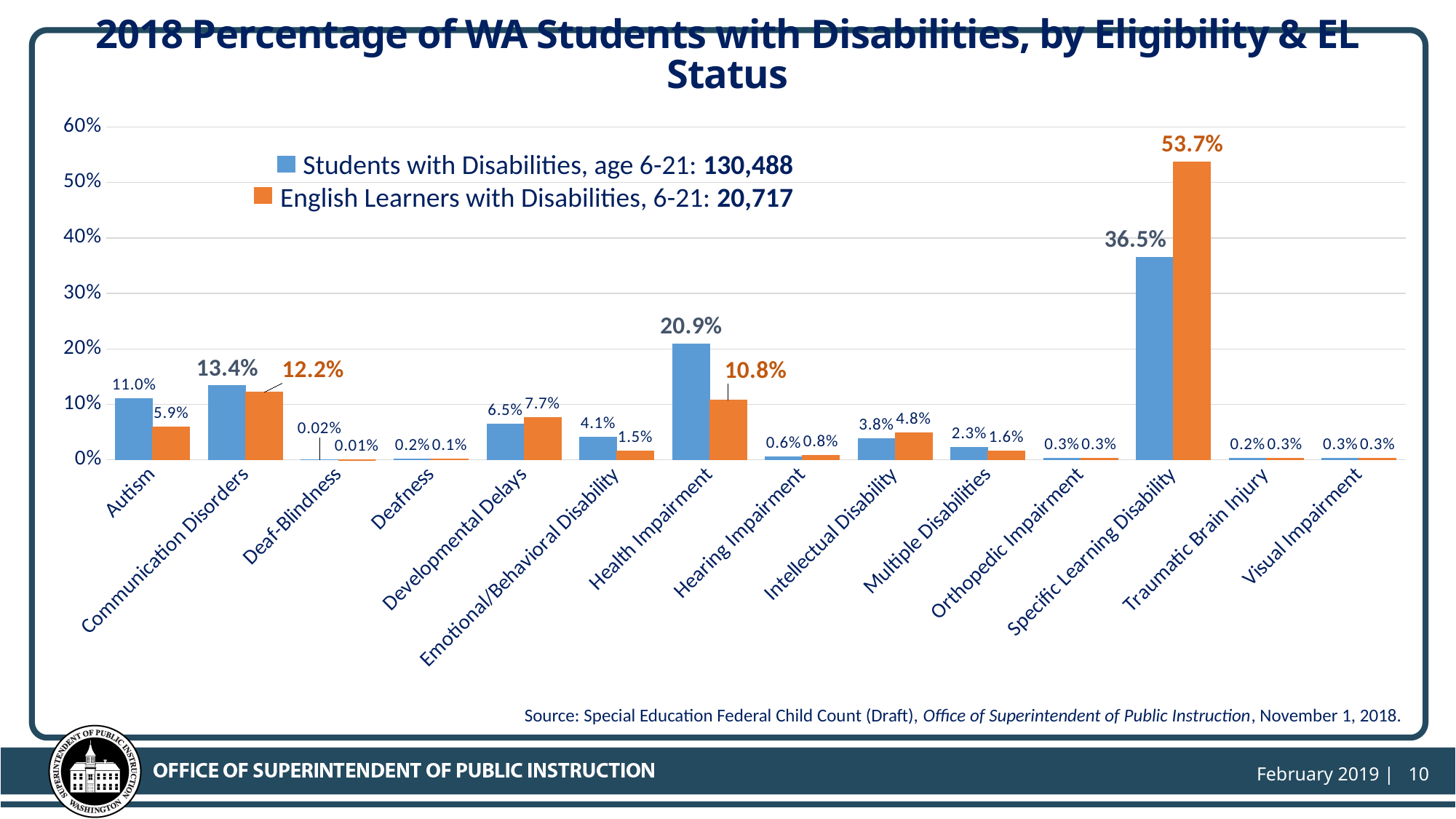
Which eligibility category has the highest value for Students with Disabilities, age 6-21? Specific Learning Disability What kind of chart is shown on the slide? Bar chart Is the value for Specific Learning Disability among English Learners with Disabilities, 6-21 greater or less than 50%? greater What percentage of English Learners with Disabilities, 6-21 have Specific Learning Disability? 53.7% How many eligibility categories are shown on the x axis? 14 What percentage of Students with Disabilities, age 6-21 have Autism as their eligibility category? 11.0% For Health Impairment, which series has the larger value: Students with Disabilities, age 6-21 or English Learners with Disabilities, 6-21? Students with Disabilities, age 6-21 How many series does the legend list? 2 Which eligibility category has the lowest value for English Learners with Disabilities, 6-21? Deaf-Blindness According to the legend, how many Students with Disabilities, age 6-21 are there? 130,488 What is the value for Health Impairment in the English Learners with Disabilities, 6-21 series? 10.8% What is the difference between the English Learners with Disabilities and Students with Disabilities values for Specific Learning Disability? 17.2%